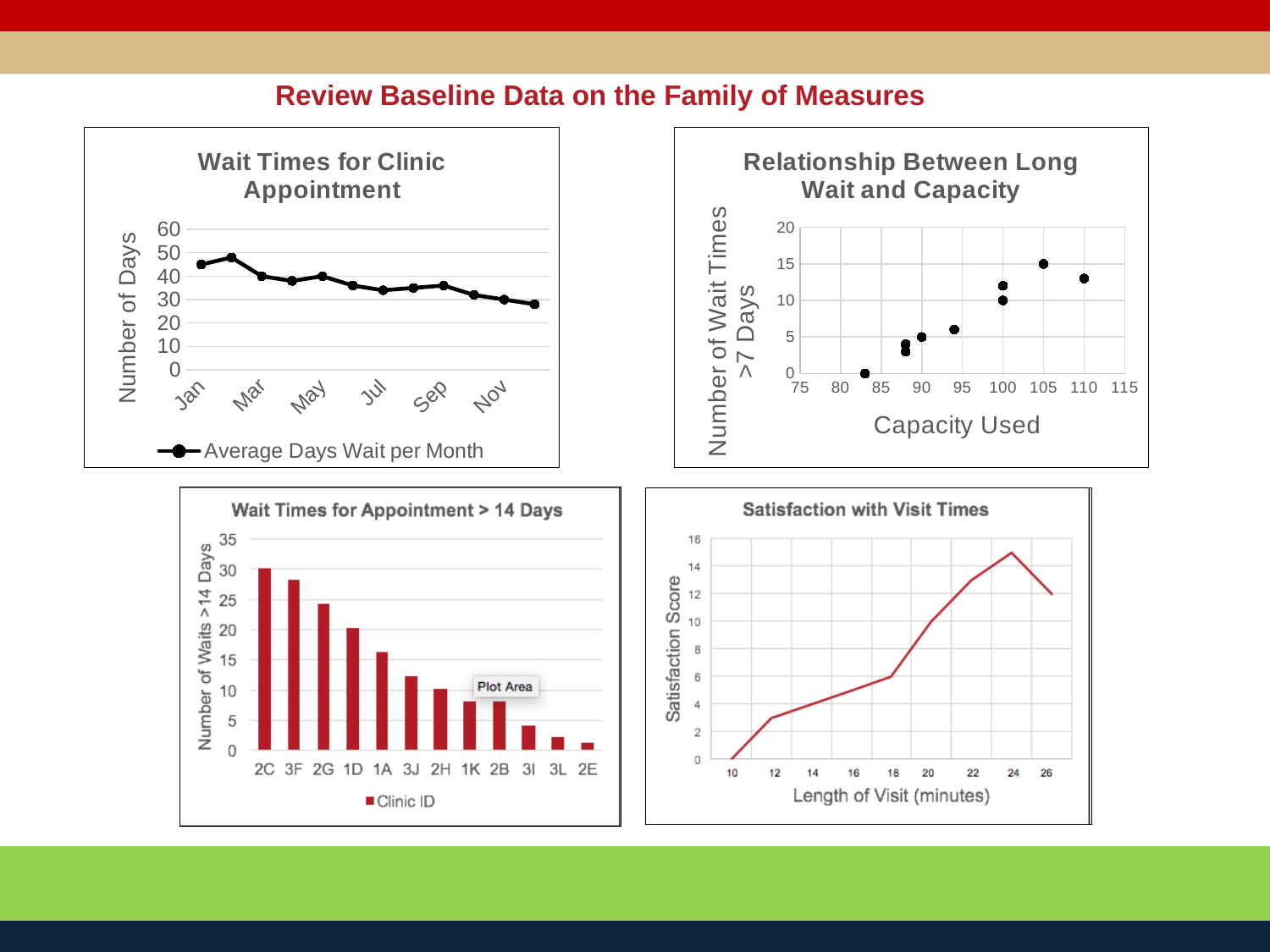
In the "Wait Times for Appointment > 14 Days" chart, which has more waits, clinic 2G or clinic 1D? 2G In the "Wait Times for Appointment > 14 Days" chart, which clinic ID has the lowest number of waits? 2E What series name does the legend of the "Wait Times for Clinic Appointment" chart show? Average Days Wait per Month In the "Relationship Between Long Wait and Capacity" chart, do the number of wait times generally rise or fall as capacity used increases? rise In the "Wait Times for Clinic Appointment" chart, is the value for Jan greater or less than 40? greater In the "Wait Times for Clinic Appointment" chart, do the values generally rise or fall from Jan to Dec? fall In the "Wait Times for Appointment > 14 Days" chart, is the value for clinic 3F greater or less than 25? greater What type of chart is "Relationship Between Long Wait and Capacity"? scatter chart In the "Satisfaction with Visit Times" chart, at which length of visit is the satisfaction score highest? 24 In the "Wait Times for Appointment > 14 Days" chart, which clinic ID has the highest number of waits? 2C How many clinic IDs are shown in the "Wait Times for Appointment > 14 Days" chart? 12 What type of chart is "Wait Times for Appointment > 14 Days"? bar chart